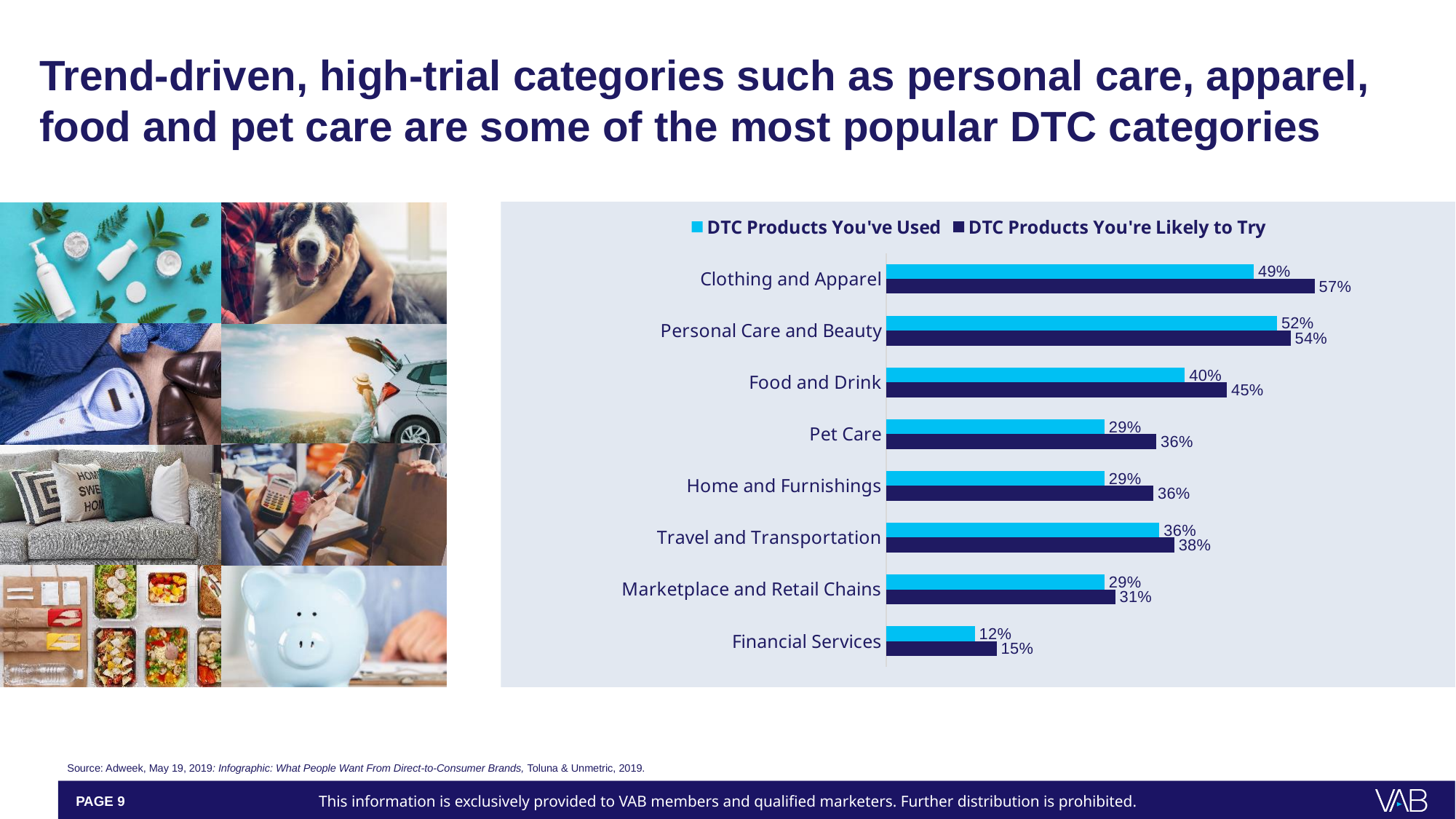
How many series does the legend list? 2 Which is larger for Pet Care: the 'DTC Products You've Used' value or the 'DTC Products You're Likely to Try' value? DTC Products You're Likely to Try What is the difference between the 'Likely to Try' and 'You've Used' values for Clothing and Apparel? 8% What is the 'DTC Products You're Likely to Try' value for Travel and Transportation? 38% What is the value for Financial Services in the 'DTC Products You're Likely to Try' series? 15% What percentage of respondents have used DTC products in the Clothing and Apparel category? 49% Which colour represents the 'DTC Products You've Used' series in the chart? Light blue What kind of chart is shown on the slide? Bar chart What is the 'DTC Products You've Used' value for Food and Drink? 40% Which category has the highest value for 'DTC Products You've Used'? Personal Care and Beauty How many categories are shown in the chart? 8 Which category has the lowest value for 'DTC Products You're Likely to Try'? Financial Services